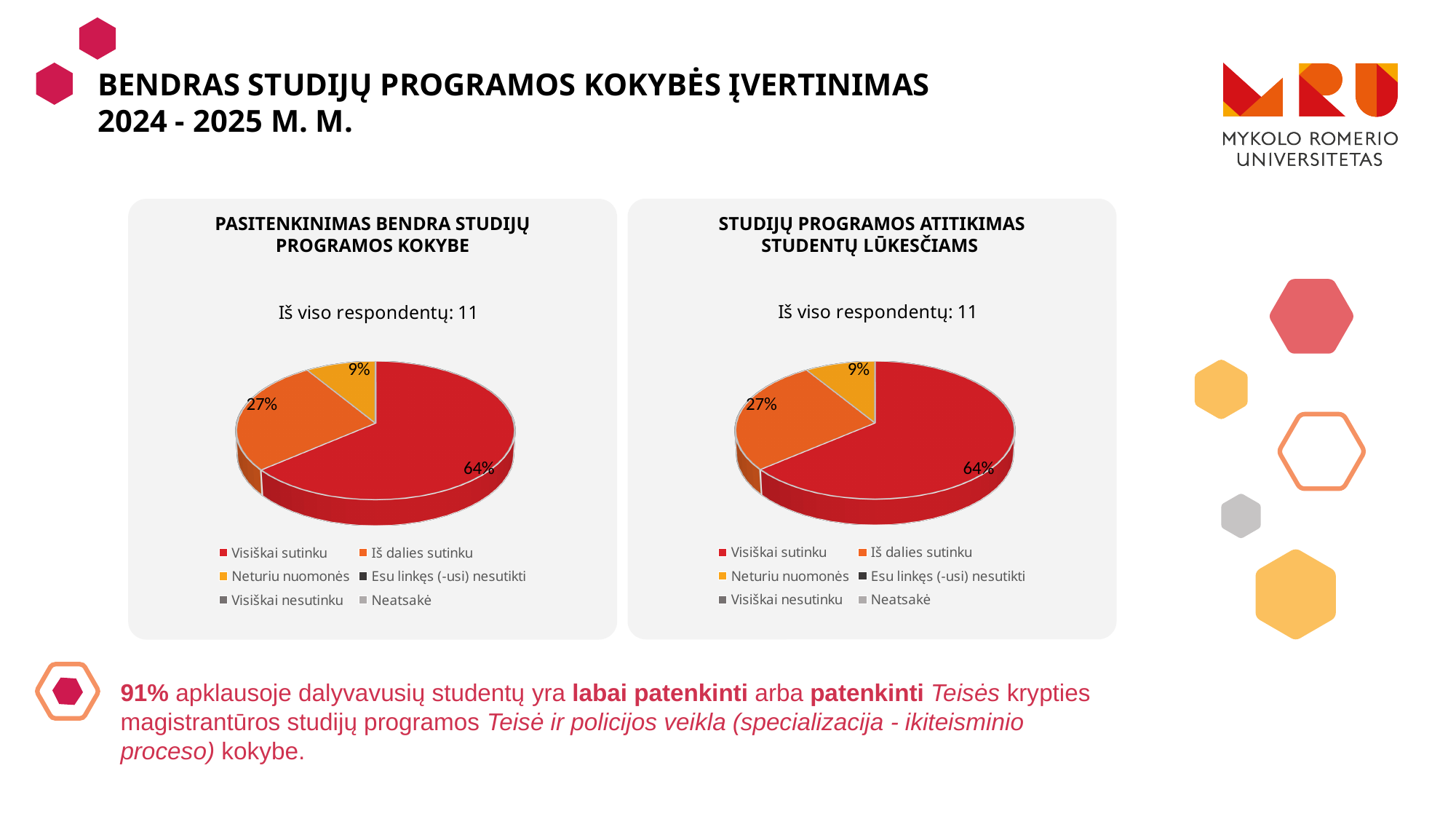
How many slices with data labels are shown in the left chart titled "Pasitenkinimas bendra studijų programos kokybe"? 3 In the right chart titled "Studijų programos atitikimas studentų lūkesčiams", what share of respondents answered "Visiškai sutinku"? 64% In the left chart titled "Pasitenkinimas bendra studijų programos kokybe", what share of respondents answered "Visiškai sutinku"? 64% What type of chart is used in the left panel titled "Pasitenkinimas bendra studijų programos kokybe"? Pie chart In the right chart titled "Studijų programos atitikimas studentų lūkesčiams", which answer category has the smallest visible slice? Neturiu nuomonės In the right chart titled "Studijų programos atitikimas studentų lūkesčiams", which is larger: the "Iš dalies sutinku" slice or the "Neturiu nuomonės" slice? Iš dalies sutinku In the right chart titled "Studijų programos atitikimas studentų lūkesčiams", what share of respondents answered "Neturiu nuomonės"? 9% In the left chart titled "Pasitenkinimas bendra studijų programos kokybe", which answer category has the largest slice? Visiškai sutinku According to the text above the right chart titled "Studijų programos atitikimas studentų lūkesčiams", how many respondents were there in total? 11 In the left chart titled "Pasitenkinimas bendra studijų programos kokybe", what is the difference in percentage points between the "Visiškai sutinku" and "Iš dalies sutinku" slices? 37 percentage points How many entries does the legend of the right chart titled "Studijų programos atitikimas studentų lūkesčiams" list? 6